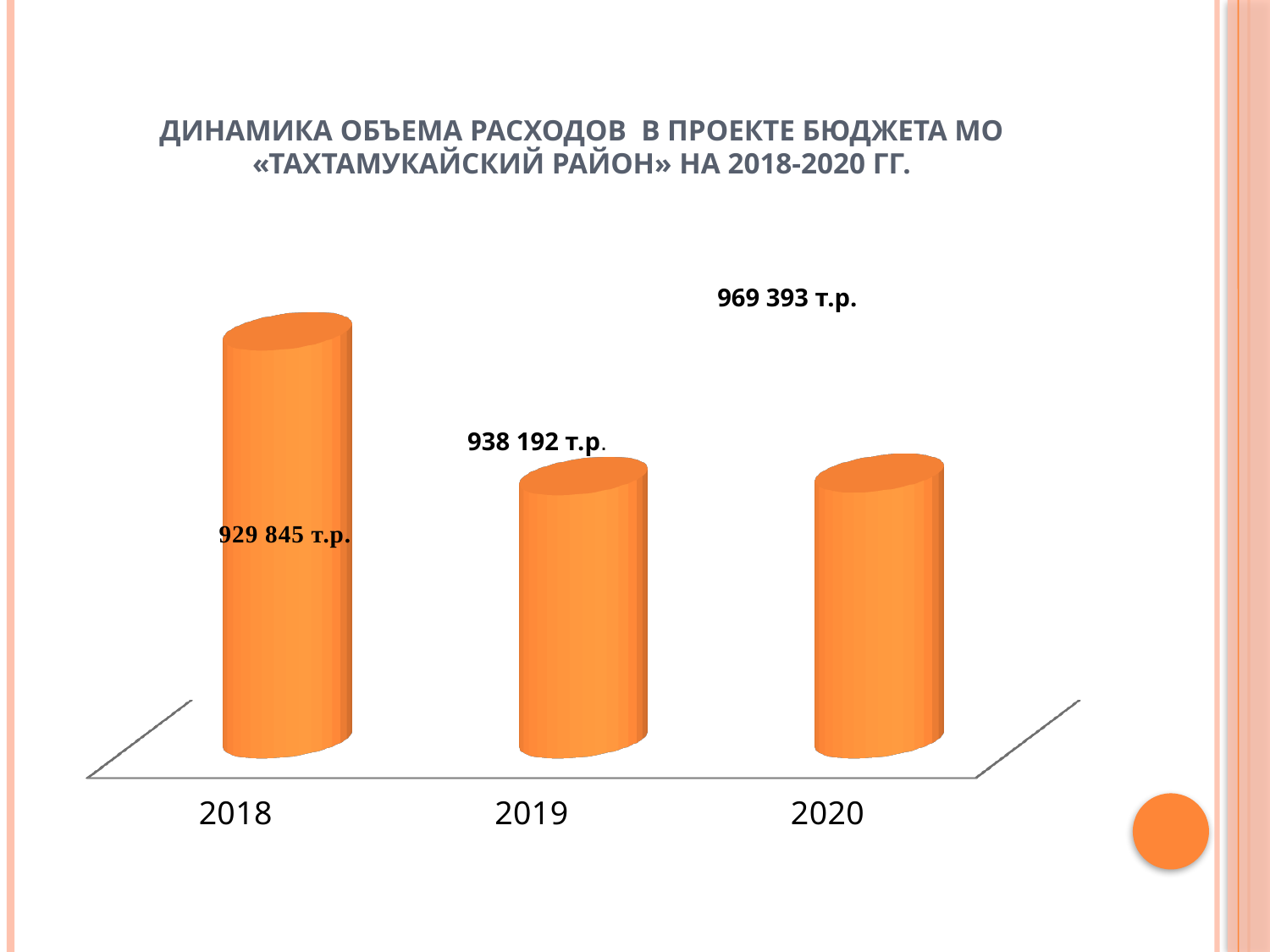
What is the difference between the labelled values for 2019 and 2018? 8 347 т.р. What is the difference between the labelled values for 2020 and 2019? 31 201 т.р. What is the value shown for 2020? 969 393 т.р. How many years are shown on the x axis? 3 What is the difference between the labelled values for 2020 and 2018? 39 548 т.р. What is the value shown for 2018? 929 845 т.р. According to the data labels, which year has the highest value? 2020 What colour are the bars in the chart? Orange What kind of chart is shown on the slide? Bar chart According to the data labels, which year has the lowest value? 2018 What is the value shown for 2019? 938 192 т.р. According to the data labels, which is larger: the value for 2019 or the value for 2020? 2020